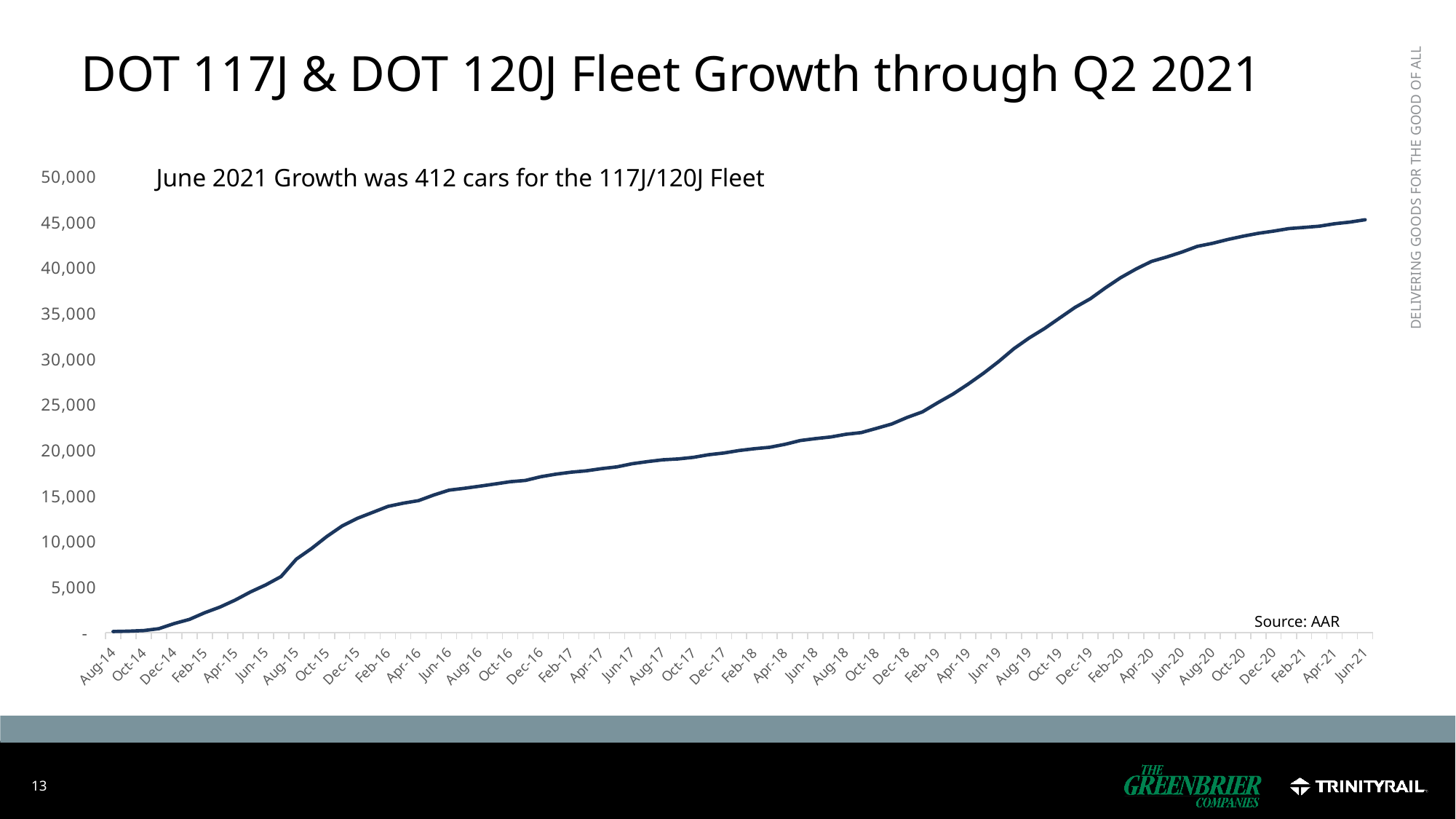
What kind of chart is shown on the slide? line chart Which month shown on the x axis has the lowest fleet value? Aug-14 Which month shown on the x axis has the highest fleet value? Jun-21 Is the value for Dec-15 greater or less than 15,000? less Is the value for Jun-21 greater or less than 40,000? greater Is the value for Dec-18 greater or less than 20,000? greater Do the fleet values rise or fall from Aug-14 to Jun-21? rise According to the annotation on the chart, how many cars did the 117J/120J fleet grow by in June 2021? 412 cars What source is cited for the chart data? AAR Which is larger, the value for Dec-16 or the value for Dec-19? Dec-19